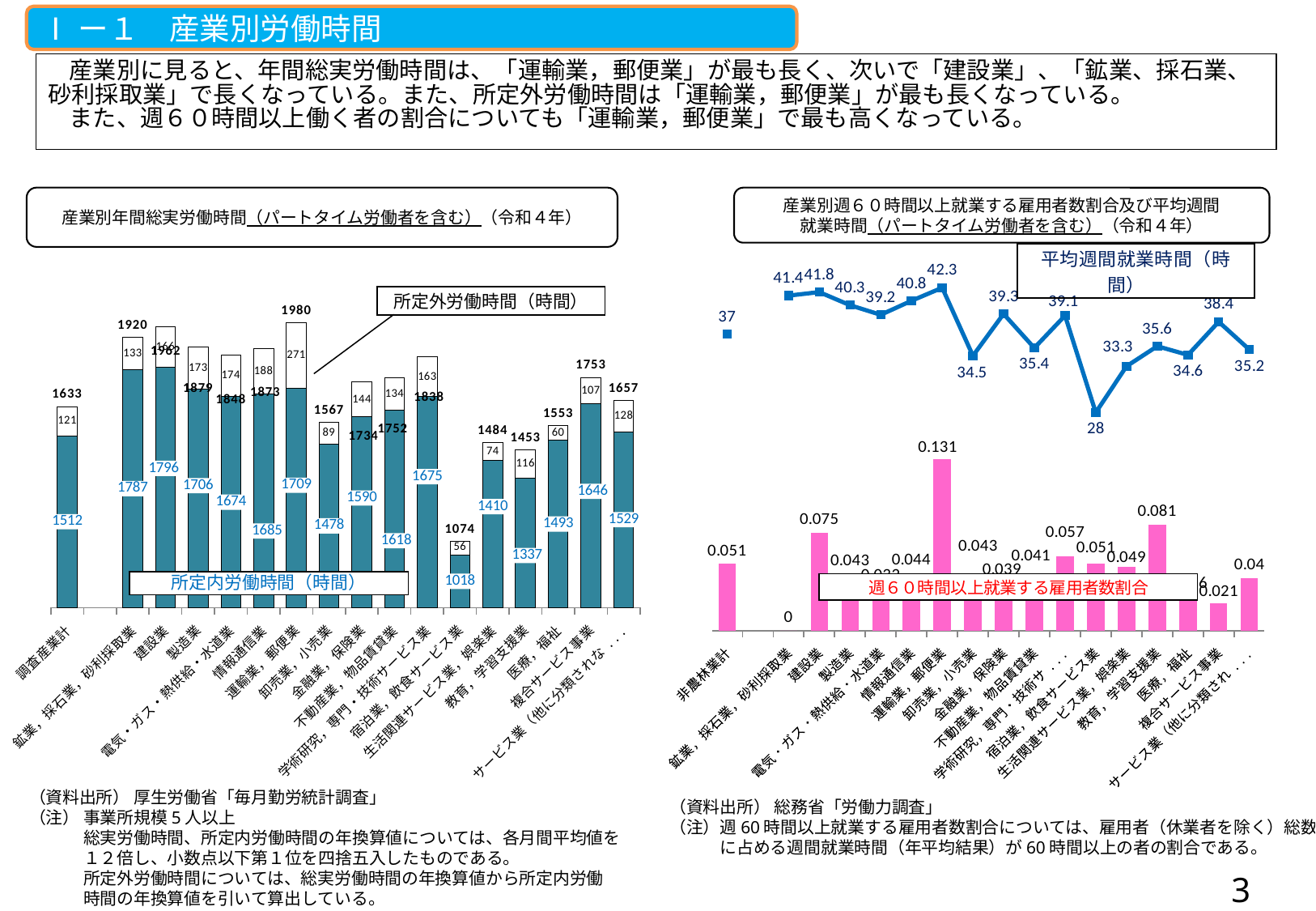
In the left chart (産業別年間総実労働時間), which industry has the lowest total annual working hours? 宿泊業，飲食サービス業 In the right chart, how many industry categories are shown on the x axis? 17 In the right chart, which is larger, the 週６０時間以上就業する雇用者数割合 for 建設業 or for 教育，学習支援業? 教育，学習支援業 In the left chart (産業別年間総実労働時間), what is the 所定外労働時間 value for 運輸業，郵便業? 271 In the right chart, which industry has the lowest 平均週間就業時間? 宿泊業，飲食サービス業 In the left chart (産業別年間総実労働時間), which industry has the highest total annual working hours? 運輸業，郵便業 In the right chart, what is the 週６０時間以上就業する雇用者数割合 for 運輸業，郵便業? 0.131 In the left chart (産業別年間総実労働時間), what is the total annual working hours for 運輸業，郵便業? 1980 In the left chart (産業別年間総実労働時間), what kind of chart is used? Stacked bar chart In the left chart (産業別年間総実労働時間), what is the difference between the total hours of 鉱業，採石業，砂利採取業 and 調査産業計? 287 In the right chart, what is the 平均週間就業時間 value for 運輸業，郵便業? 42.3 In the left chart (産業別年間総実労働時間), what is the 所定内労働時間 value for 宿泊業，飲食サービス業? 1018